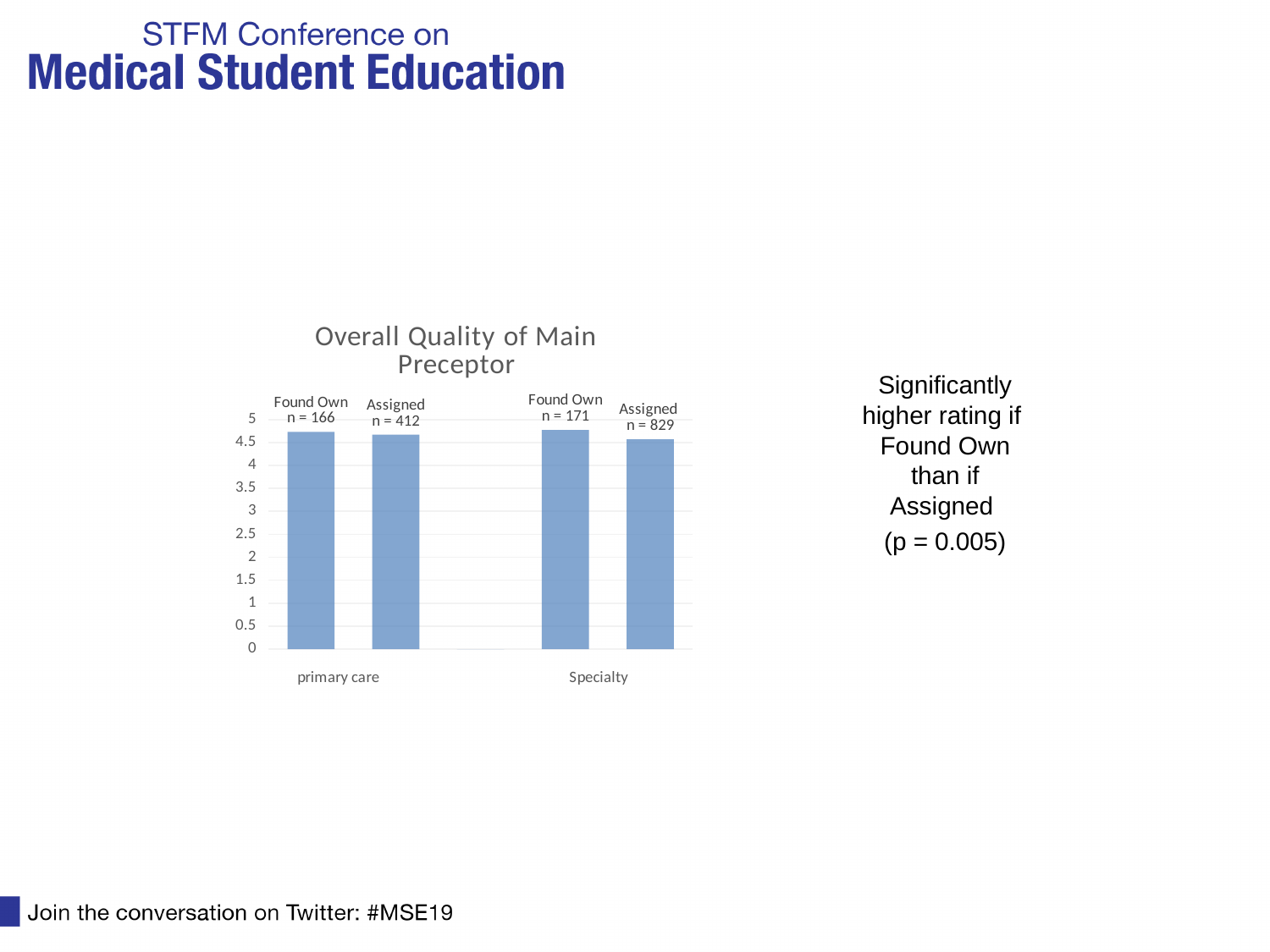
Is the value for Assigned in Specialty greater or less than 4? greater How many bars are plotted in the chart? 4 What kind of chart is shown on the slide? bar chart In the primary care group, which bar is higher, Found Own or Assigned? Found Own Is the value for Assigned in primary care greater or less than 3? greater What sample size is shown for the Assigned bar in the Specialty group? n = 829 What is the title of the chart? Overall Quality of Main Preceptor What are the two category groups labelled on the x axis? primary care and Specialty Which bar has the lowest value in the chart? Assigned in Specialty How many category groups are shown along the x axis of the chart? 2 In the Specialty group, which bar is higher, Found Own or Assigned? Found Own Is the value for Found Own in primary care greater or less than 4? greater